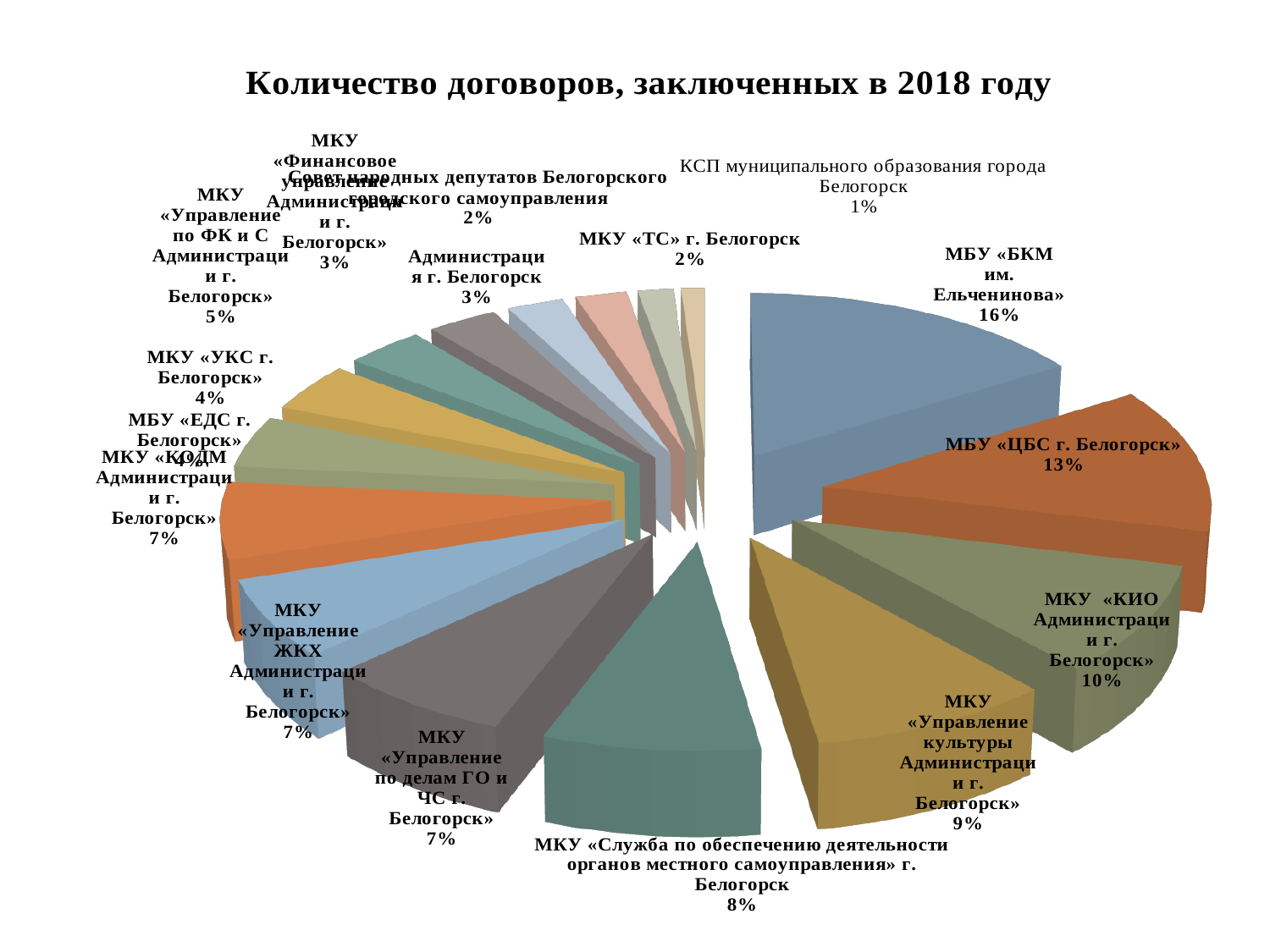
What percentage is shown for МКУ «КИО Администрации г. Белогорск»? 10% What kind of chart is shown on the slide? pie chart Which category has the largest share of the pie? МБУ «БКМ им. Ельченинова» What share of the pie does МБУ «БКМ им. Ельченинова» have? 16% What percentage is shown for МКУ «Управление культуры Администрации г. Белогорск»? 9% Which has a larger share: МКУ «Управление по ФК и С Администрации г. Белогорск» or МКУ «УКС г. Белогорск»? МКУ «Управление по ФК и С Администрации г. Белогорск» What is the title of the chart? Количество договоров, заключенных в 2018 году Which category has the smallest share of the pie? КСП муниципального образования города Белогорск What share of the pie does МБУ «ЦБС г. Белогорск» have? 13% What percentage is shown for МКУ «ТС» г. Белогорск? 2% What percentage is shown for МКУ «Служба по обеспечению деятельности органов местного самоуправления» г. Белогорск? 8% What is the difference in percentage points between МБУ «БКМ им. Ельченинова» and МБУ «ЦБС г. Белогорск»? 3